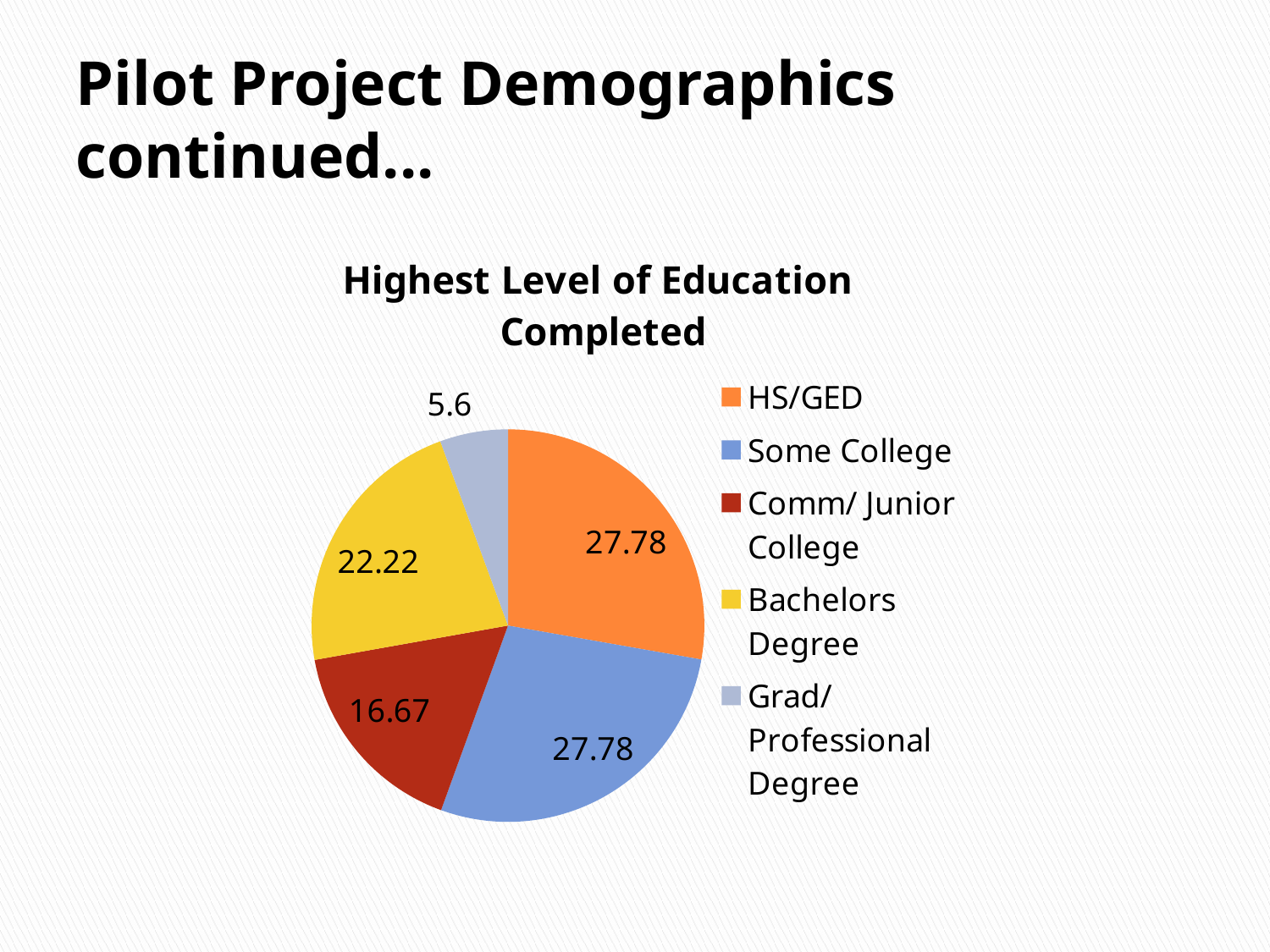
What value is shown for the Comm/ Junior College slice? 16.67 What value is shown for the HS/GED slice? 27.78 What is the title of the chart? Highest Level of Education Completed Which category has the smallest slice of the pie? Grad/ Professional Degree Which is larger, the Bachelors Degree slice or the Comm/ Junior College slice? Bachelors Degree What type of chart is shown on the slide? pie chart How many categories does the legend list? 5 What value is shown for the Grad/ Professional Degree slice? 5.6 What is the difference between the Some College value and the Comm/ Junior College value? 11.11 What value is shown for the Bachelors Degree slice? 22.22 What is the difference between the Bachelors Degree value and the Grad/ Professional Degree value? 16.62 What colour is the Some College slice? blue